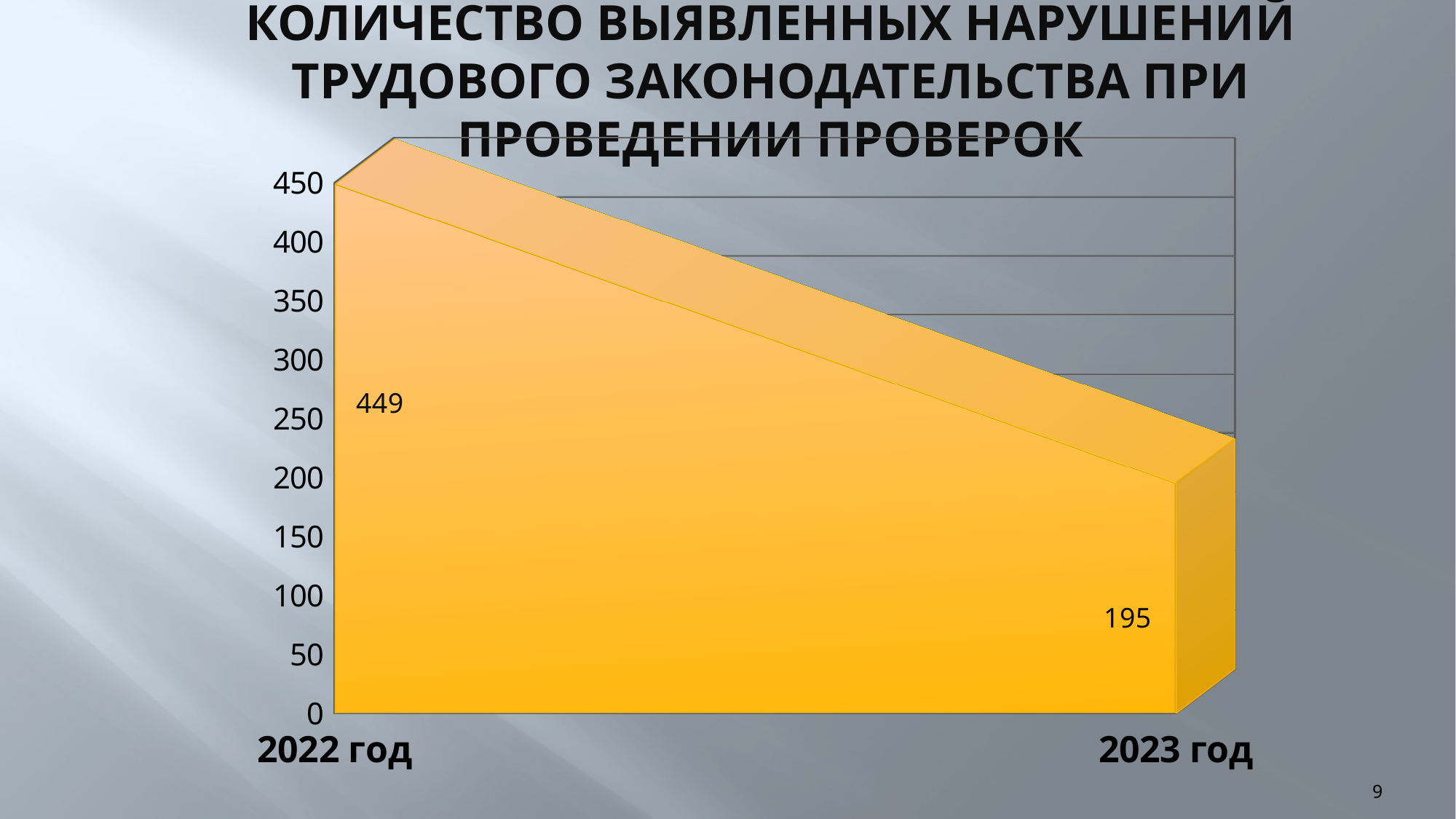
Do the values rise or fall from 2022 год to 2023 год? fall Which is larger, the value for 2022 год or the value for 2023 год? 2022 год What is the value for 2023 год? 195 Is the value for 2023 год greater or less than 200? less How many categories are shown on the x axis? 2 What kind of chart is shown on the slide? 3D area chart Which year has the highest value? 2022 год What is the difference between the values for 2022 год and 2023 год? 254 What is the title of the chart? КОЛИЧЕСТВО ВЫЯВЛЕННЫХ НАРУШЕНИЙ ТРУДОВОГО ЗАКОНОДАТЕЛЬСТВА ПРИ ПРОВЕДЕНИИ ПРОВЕРОК What is the value for 2022 год? 449 Which year has the lowest value? 2023 год Is the value for 2022 год greater or less than 400? greater